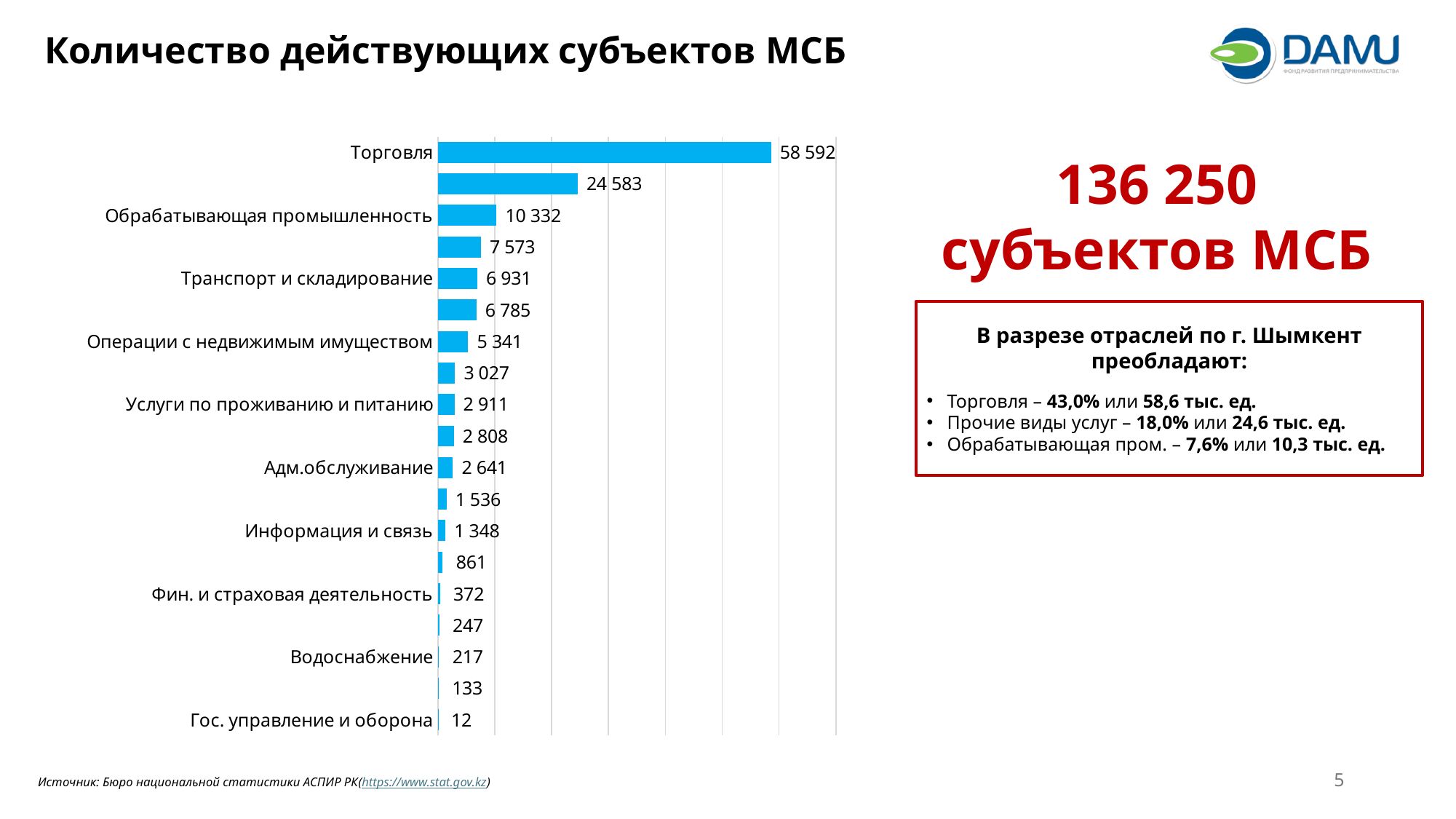
What is the value for Обрабатывающая промышленность? 10 332 What is the value for Торговля? 58 592 Which category has the lowest value? Гос. управление и оборона How many bars are plotted in the chart? 19 What is the value for Транспорт и складирование? 6 931 Which is larger, the value for Адм.обслуживание or the value for Услуги по проживанию и питанию? Услуги по проживанию и питанию What is the difference between the values for Торговля and Обрабатывающая промышленность? 48 260 What is the value for Водоснабжение? 217 What is the value for Операции с недвижимым имуществом? 5 341 What kind of chart is shown on the slide? Bar chart Which category has the highest value? Торговля What is the value for Информация и связь? 1 348